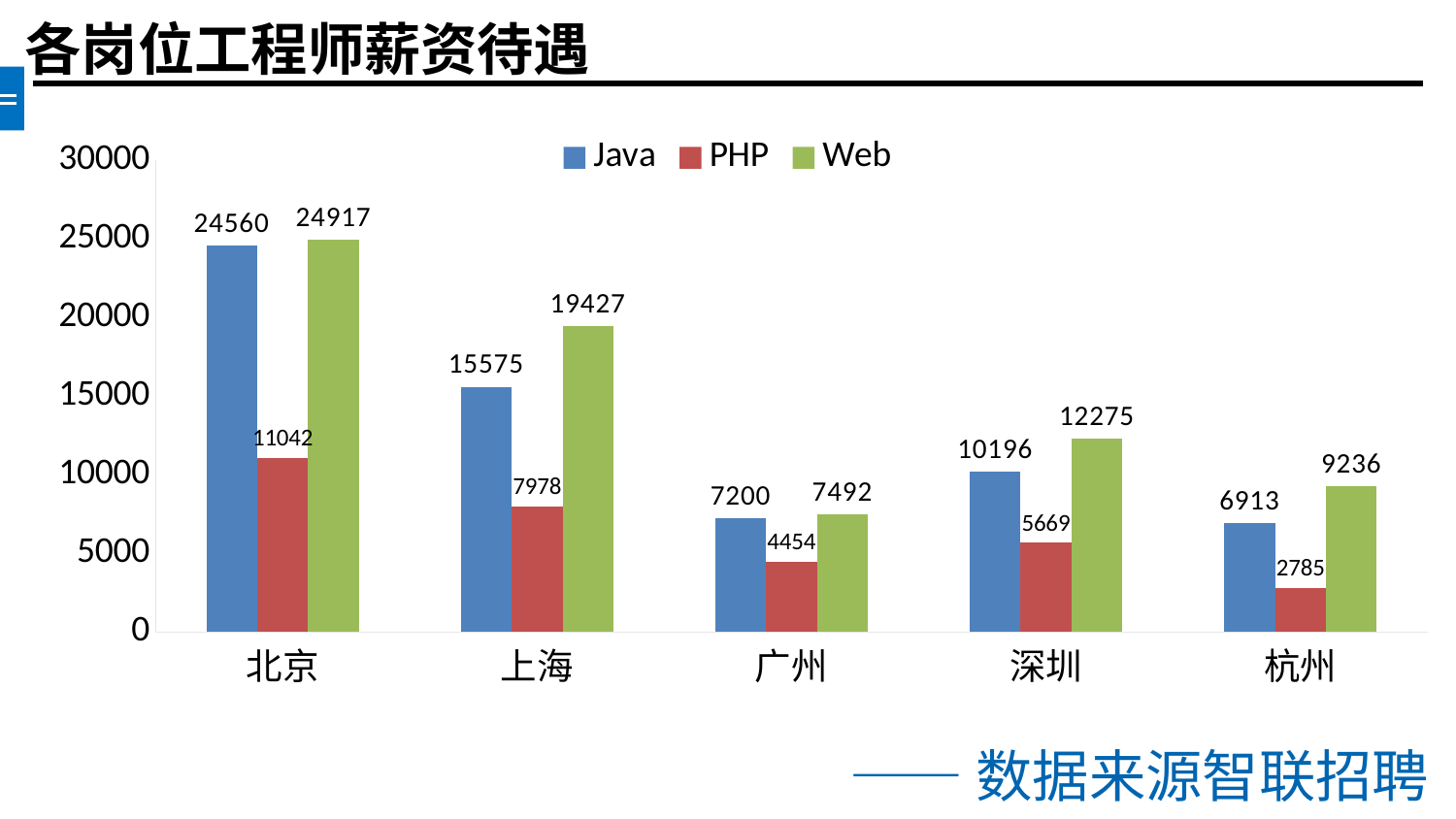
How many cities are shown on the x axis? 5 Which is larger for 广州, the Java value or the Web value? Web Which city has the highest Web value? 北京 What kind of chart is shown on the slide? bar chart Which city has the lowest PHP value? 杭州 What is the PHP value for 杭州? 2785 What is the Java value for 北京? 24560 What is the difference between the Web and Java values for 上海? 3852 What is the PHP value for 上海? 7978 Is the Java value for 深圳 greater or less than 10000? greater What is the Web value for 深圳? 12275 How many series does the legend list? 3